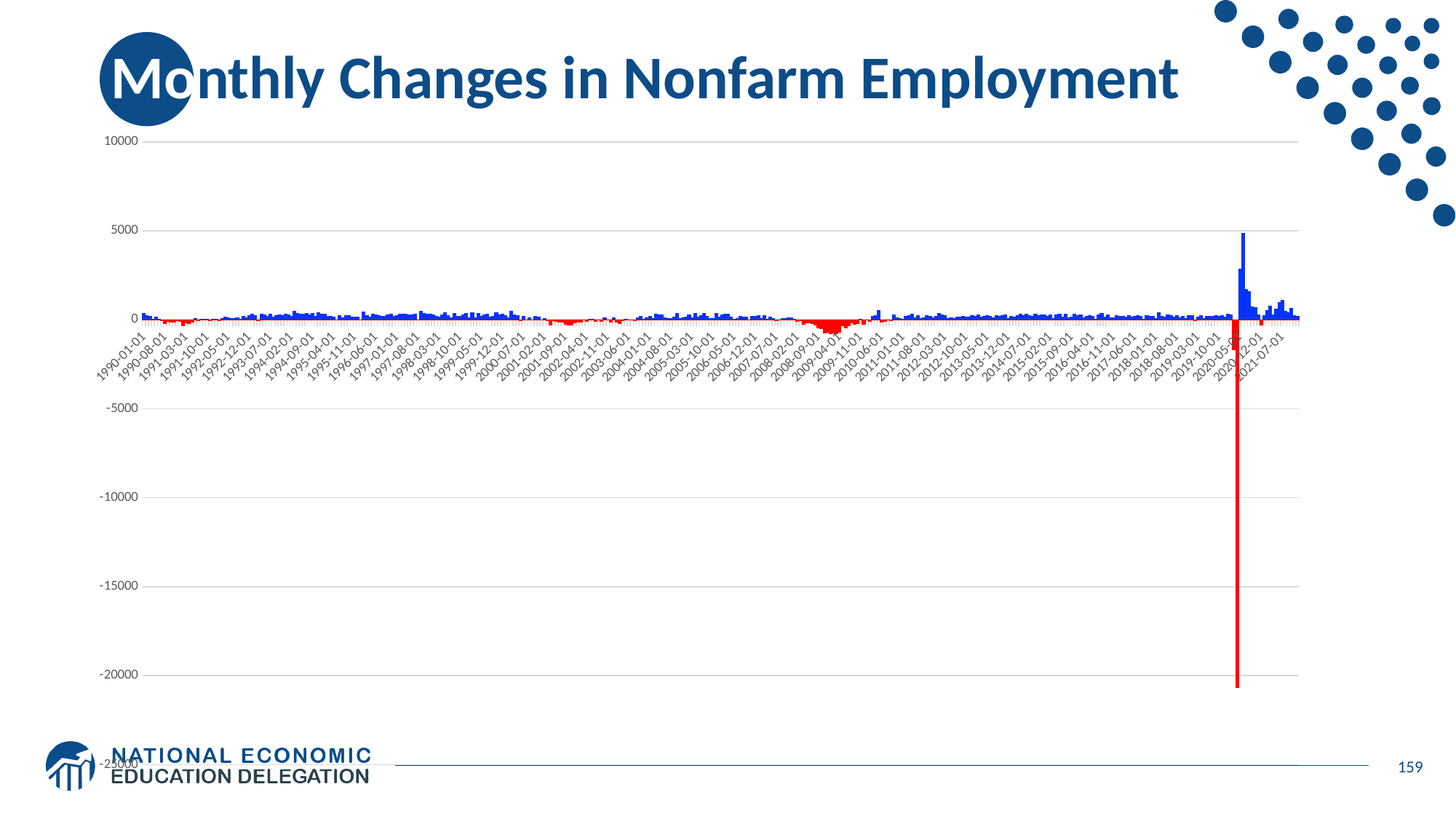
Is the value for 2009-04-01 greater or less than 0? less In which year does the largest negative monthly change occur? 2020 In which year does the largest positive monthly change occur? 2020 Is the value of the largest negative bar greater or less than -20000? less Is the value for 1994-02-01 greater or less than 5000? less What kind of chart is shown on the slide? bar chart What colour are the bars with negative values? red What is the title of the chart? Monthly Changes in Nonfarm Employment Which is larger in absolute size, the biggest positive bar or the biggest negative bar? the biggest negative bar